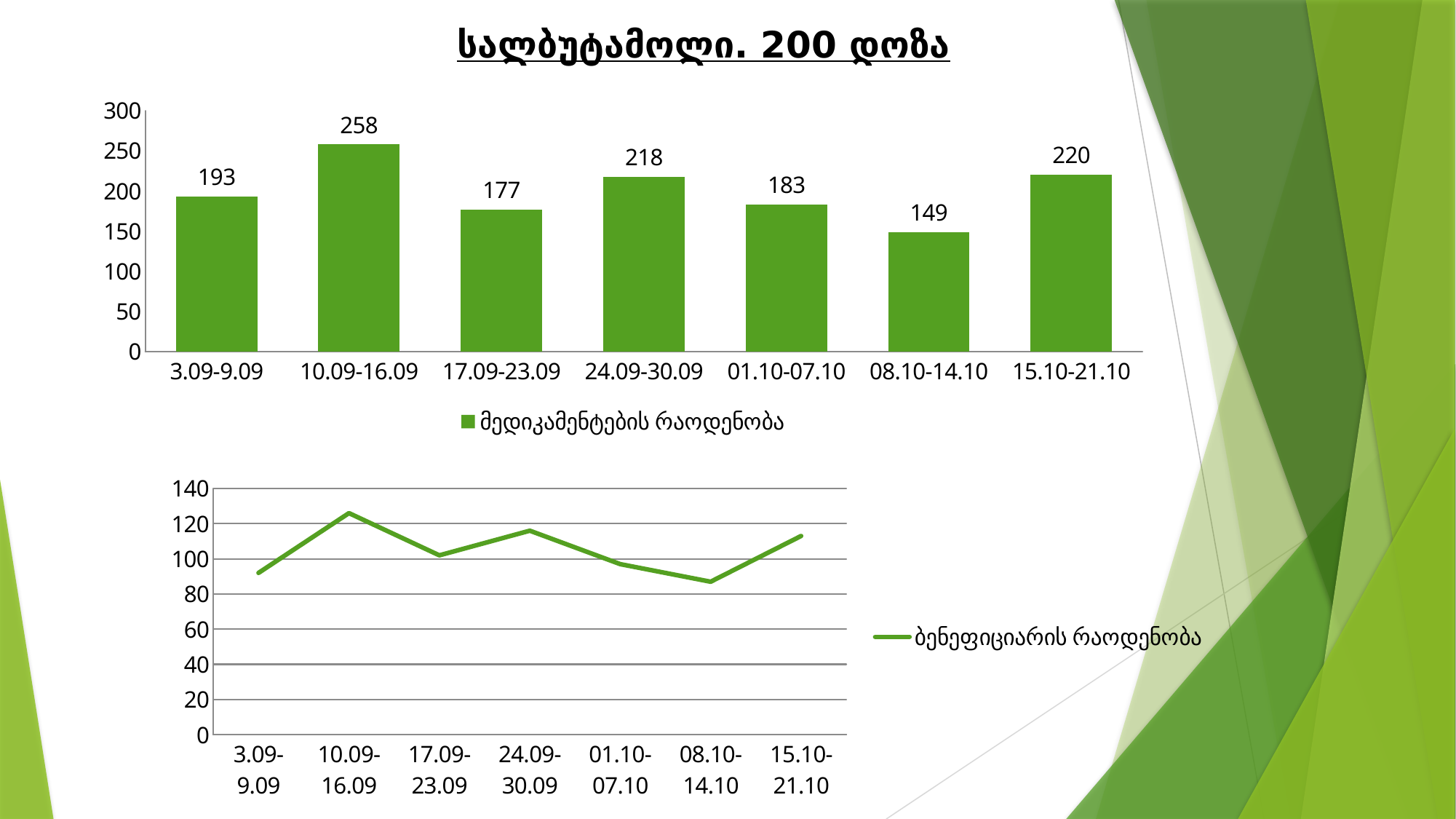
In the top bar chart, which period has the highest value? 10.09-16.09 What kind of chart is the bottom chart on the slide? line chart What kind of chart is the top chart on the slide? bar chart In the top bar chart, which period has the lowest value? 08.10-14.10 In the top bar chart, what is the value for 08.10-14.10? 149 In the top bar chart, which is larger: the value for 24.09-30.09 or the value for 15.10-21.10? 15.10-21.10 In the top bar chart, what is the value for 10.09-16.09? 258 In the bottom line chart, is the value for 10.09-16.09 greater or less than 120? greater In the top bar chart, what is the difference between the values for 10.09-16.09 and 17.09-23.09? 81 How many bars are in the top bar chart? 7 In the bottom line chart, is the value for 08.10-14.10 greater or less than 100? less What is the legend entry of the bottom line chart? ბენეფიციარის რაოდენობა